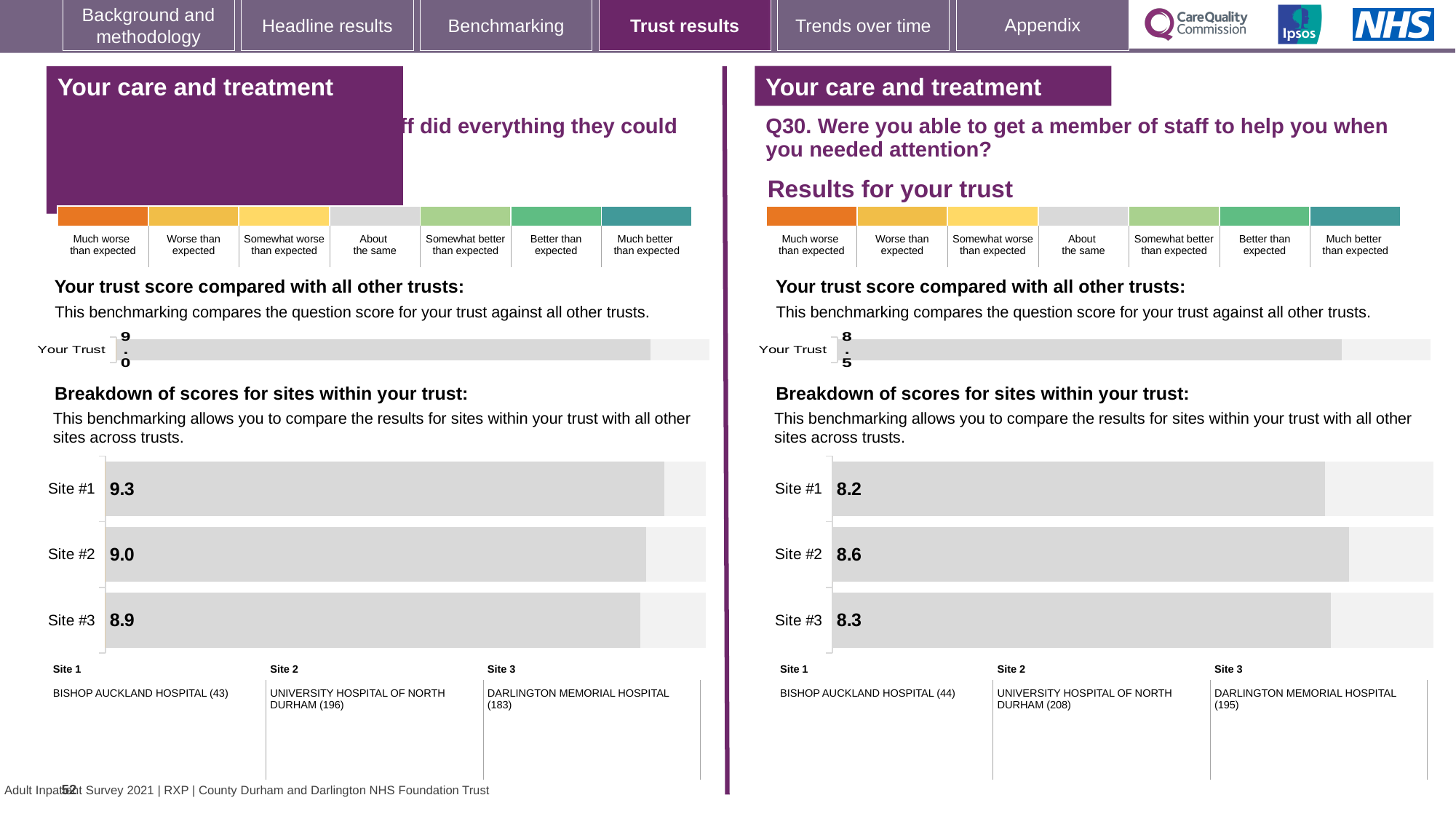
On the right-hand (Q30) site breakdown chart, what is the difference between the scores for Site #2 and Site #1? 0.4 How many sites are shown on the right-hand (Q30) site breakdown chart? 3 On the right-hand (Q30) site breakdown chart, which site has the lowest score? Site #1 On the right-hand (Q30) site breakdown chart, which site has the highest score? Site #2 On the left-hand site breakdown chart, what is the score for Site #1? 9.3 What type of chart is used for the site breakdown on the left-hand side of the slide? Bar chart On the left-hand site breakdown chart, what is the difference between the scores for Site #1 and Site #3? 0.4 On the left-hand site breakdown chart, which has the higher score, Site #2 or Site #3? Site #2 On the right-hand (Q30) 'Your trust score compared with all other trusts' chart, what is the score shown for Your Trust? 8.5 On the left-hand 'Your trust score compared with all other trusts' chart, what is the score shown for Your Trust? 9.0 On the left-hand site breakdown chart, which site has the highest score? Site #1 On the right-hand (Q30) site breakdown chart, what is the score for Site #2? 8.6